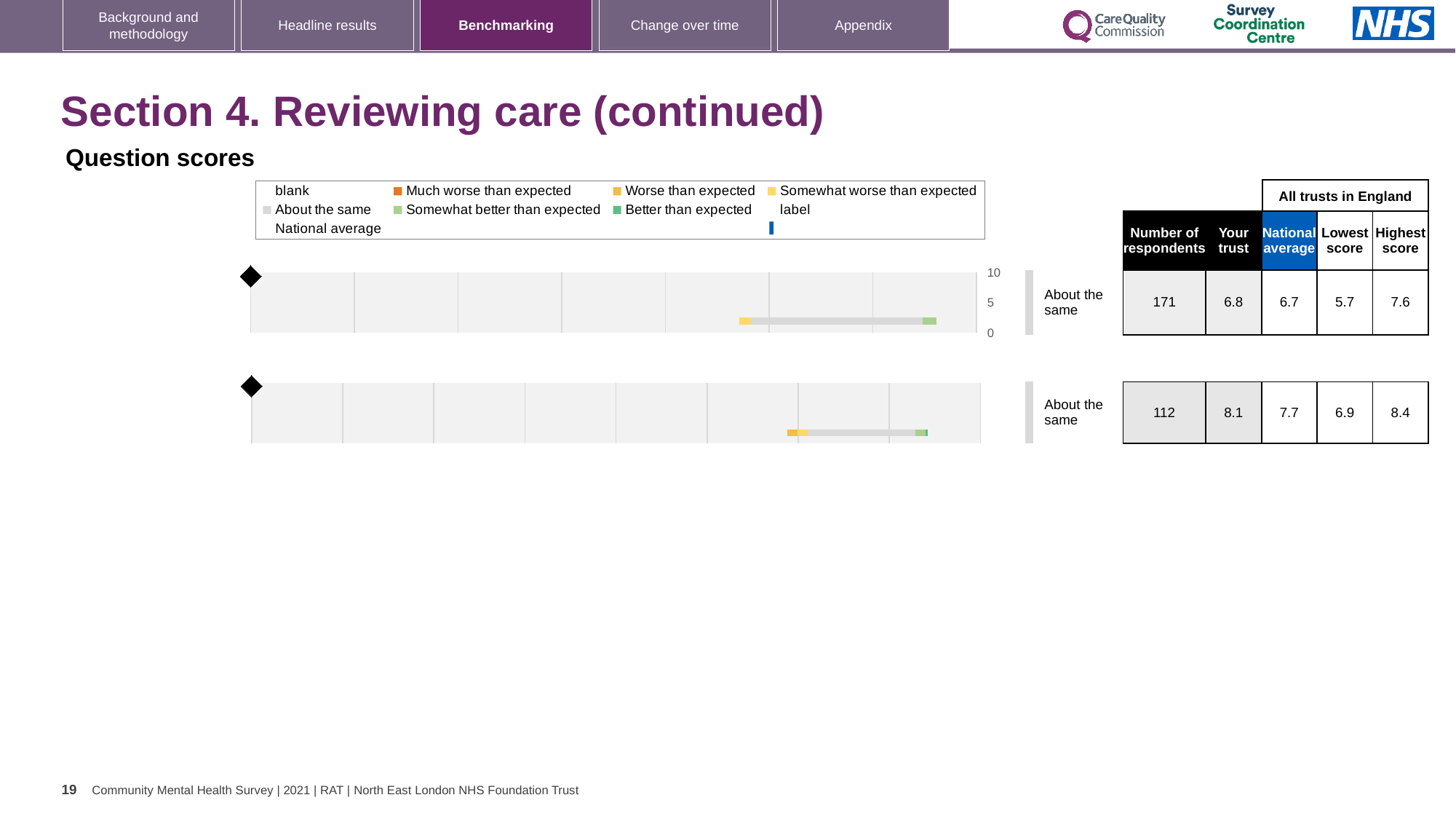
In the top chart, how many respondents are there? 171 In the bottom chart, what is the score for Your trust? 8.1 In the top chart, what is the National average score? 6.7 In the top chart, what is the score for Your trust? 6.8 In the top chart, what is the difference between the Highest score and the Lowest score? 1.9 What rating label is shown next to the bottom chart? About the same In the top chart, which is larger, the Your trust score or the National average? Your trust In the bottom chart, what is the Highest score among all trusts in England? 8.4 In the bottom chart, what is the difference between Your trust score and the National average? 0.4 How many question score charts are shown on the slide? 2 In the bottom chart, is the Lowest score greater or less than 5? greater What kind of chart is used to show the question scores on this slide? Bar chart